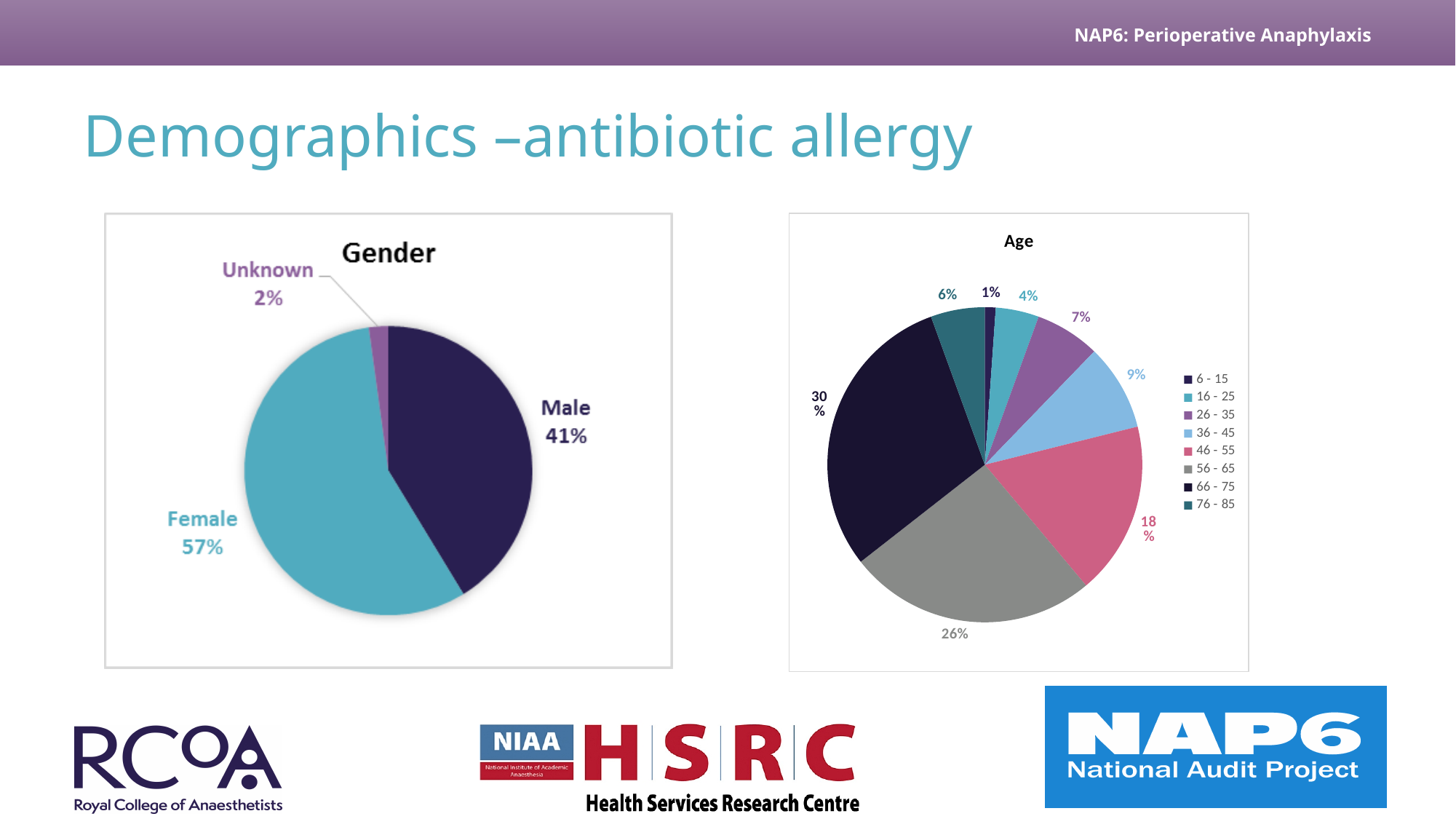
In the Gender chart, what percentage is Female? 57% In the Age chart, what percentage is the 66 - 75 group? 30% In the Gender chart, what is the difference between the Female and Male percentages? 16% In the Age chart, which age group has the smallest share? 6 - 15 In the Age chart, how many age groups does the legend list? 8 In the Age chart, what percentage is the 46 - 55 group? 18% In the Gender chart, what percentage is Unknown? 2% What kind of chart is the Gender chart? Pie chart In the Age chart, which is larger, the 56 - 65 group or the 46 - 55 group? 56 - 65 In the Age chart, which age group has the largest share? 66 - 75 In the Gender chart, which category has the largest share? Female In the Gender chart, what percentage is Male? 41%